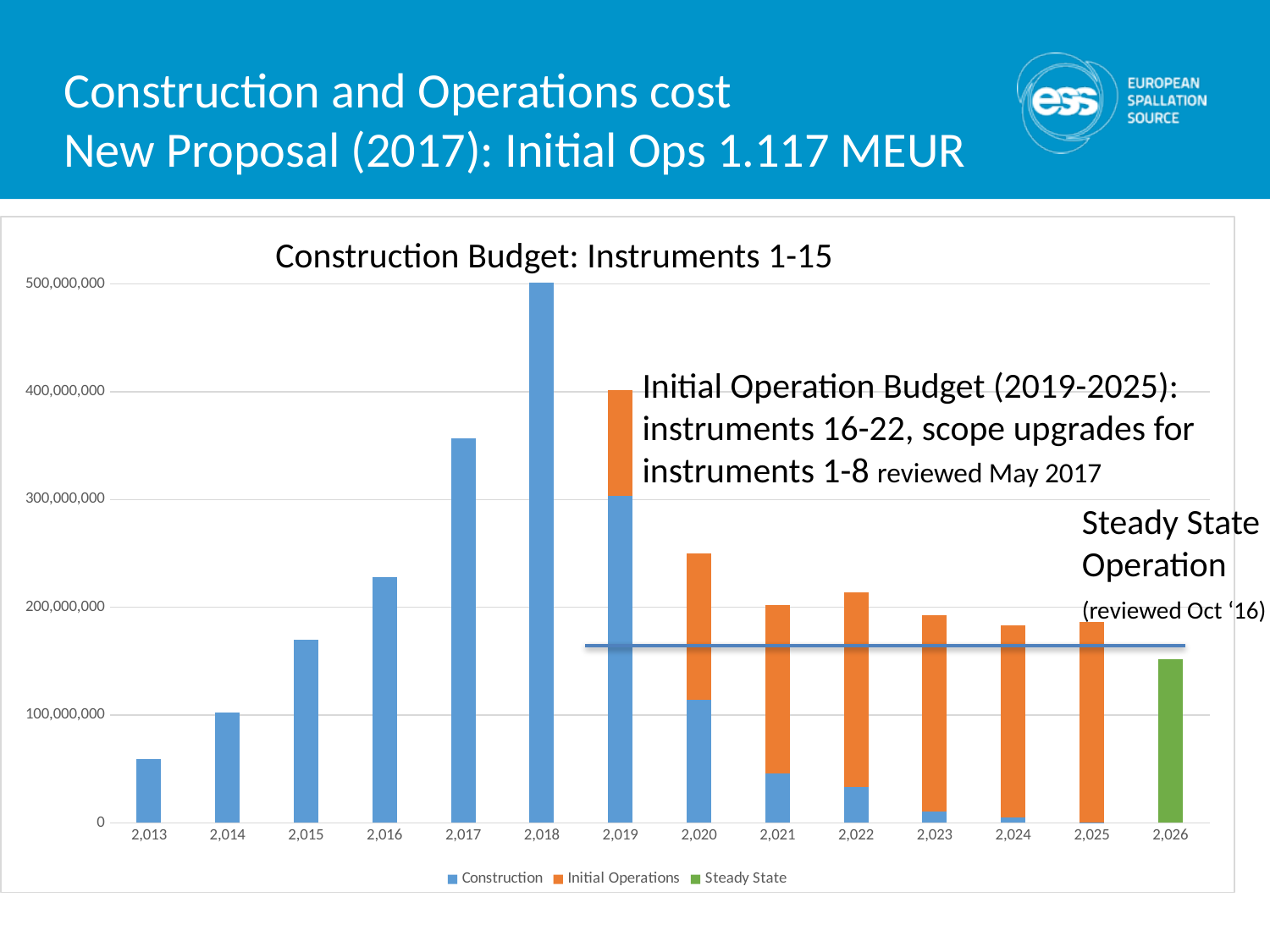
Is the Steady State value for 2026 greater or less than 100,000,000? greater Is the value for 2013 greater or less than 100,000,000? less Which bar is taller, 2016 or 2017? 2017 Which year has the shortest bar in the chart? 2013 How many years are shown along the x axis of the chart? 14 Is the value for 2017 greater or less than 300,000,000? greater How many series does the chart legend list? 3 What kind of chart is shown on the slide? Bar chart Which series is shown in green in the chart legend? Steady State Which year has the tallest bar in the chart? 2018 Do the Construction values rise or fall from 2013 to 2018? Rise